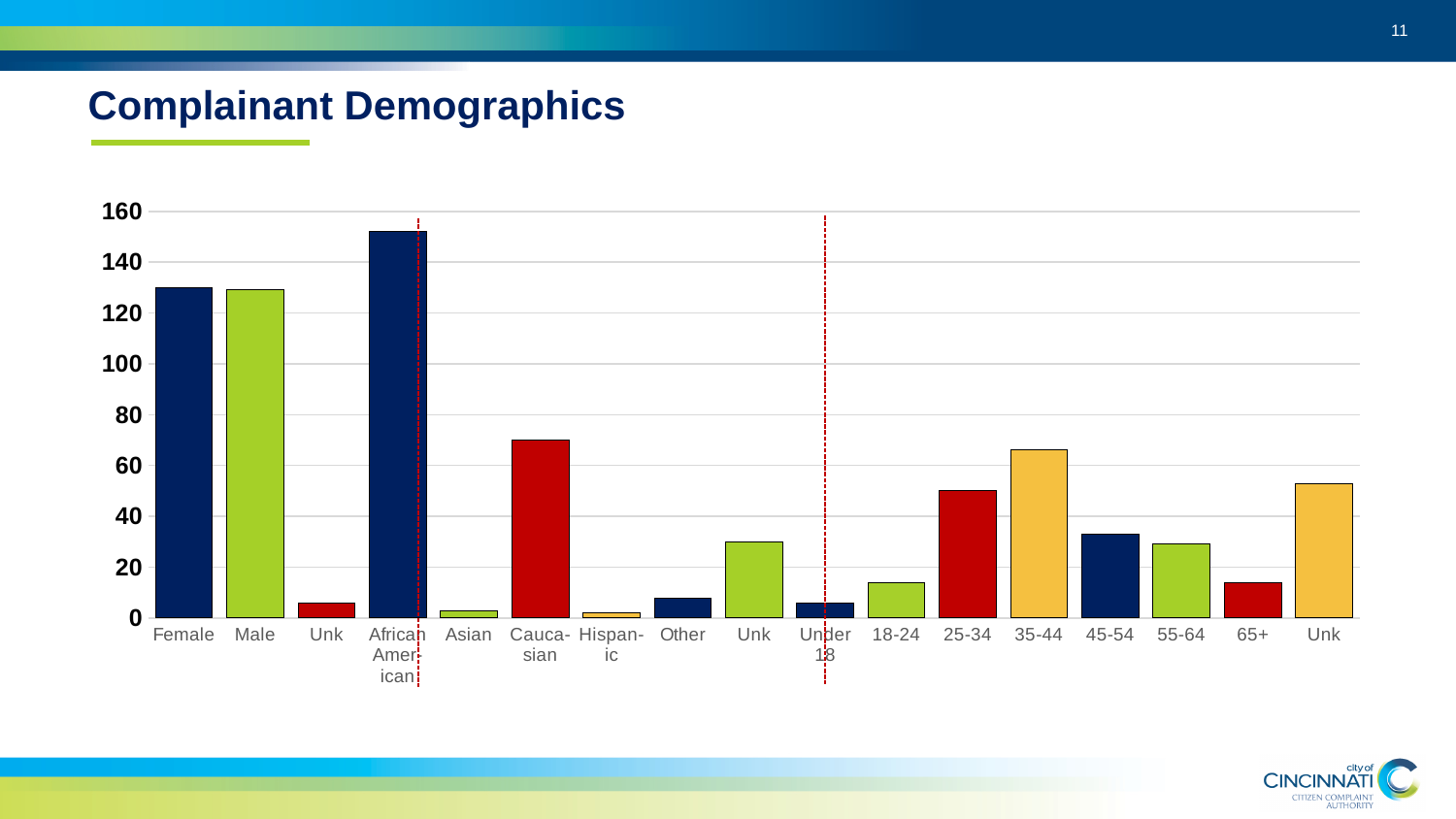
Which is larger, the value for Female or the value for Caucasian? Female Is the value for African American greater or less than 140? greater Which is larger, the value for 35-44 or the value for 55-64? 35-44 What is the title of the slide's chart? Complainant Demographics Which category has the highest bar in the chart? African American Is the value for 45-54 greater or less than 40? less Is the value for 25-34 greater or less than 40? greater How many red dashed vertical lines divide the chart into sections? 2 How many bars (categories) are plotted in the chart? 17 What kind of chart is shown on the slide? bar chart